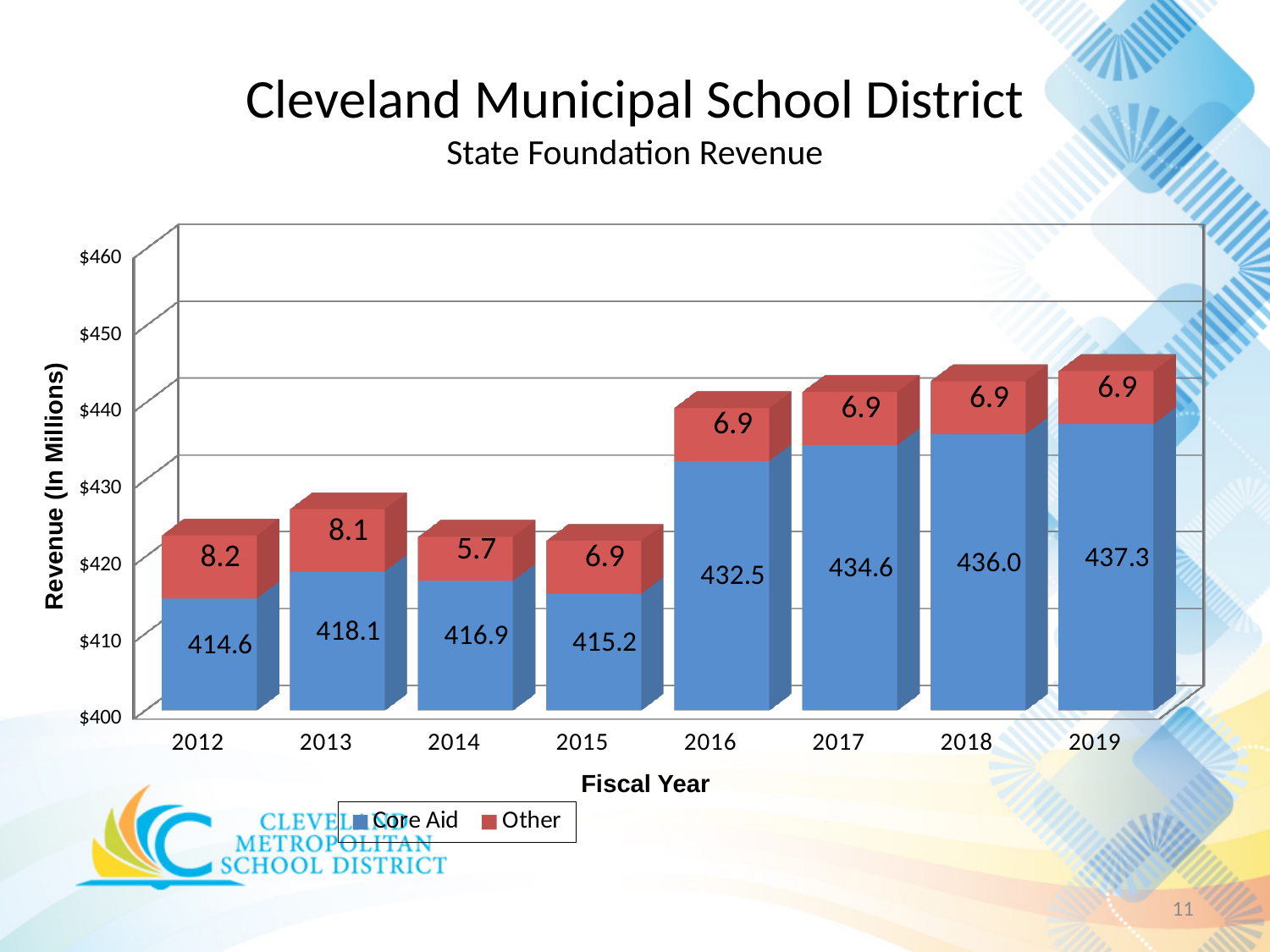
Is the Core Aid value larger in 2013 or in 2015? 2013 What is the label of the y axis? Revenue (In Millions) What is the total of the stacked bar for fiscal year 2018? 442.9 How many series does the legend list? 2 How many fiscal years are shown on the x axis? 8 What is the difference between the Core Aid values for 2019 and 2012? 22.7 What is the Core Aid value for fiscal year 2016? 432.5 Which fiscal year has the highest Core Aid value? 2019 Which fiscal year has the lowest Other value? 2014 What is the Other value for fiscal year 2014? 5.7 What kind of chart is shown on the slide? Stacked bar chart Which fiscal year has the lowest Core Aid value? 2012